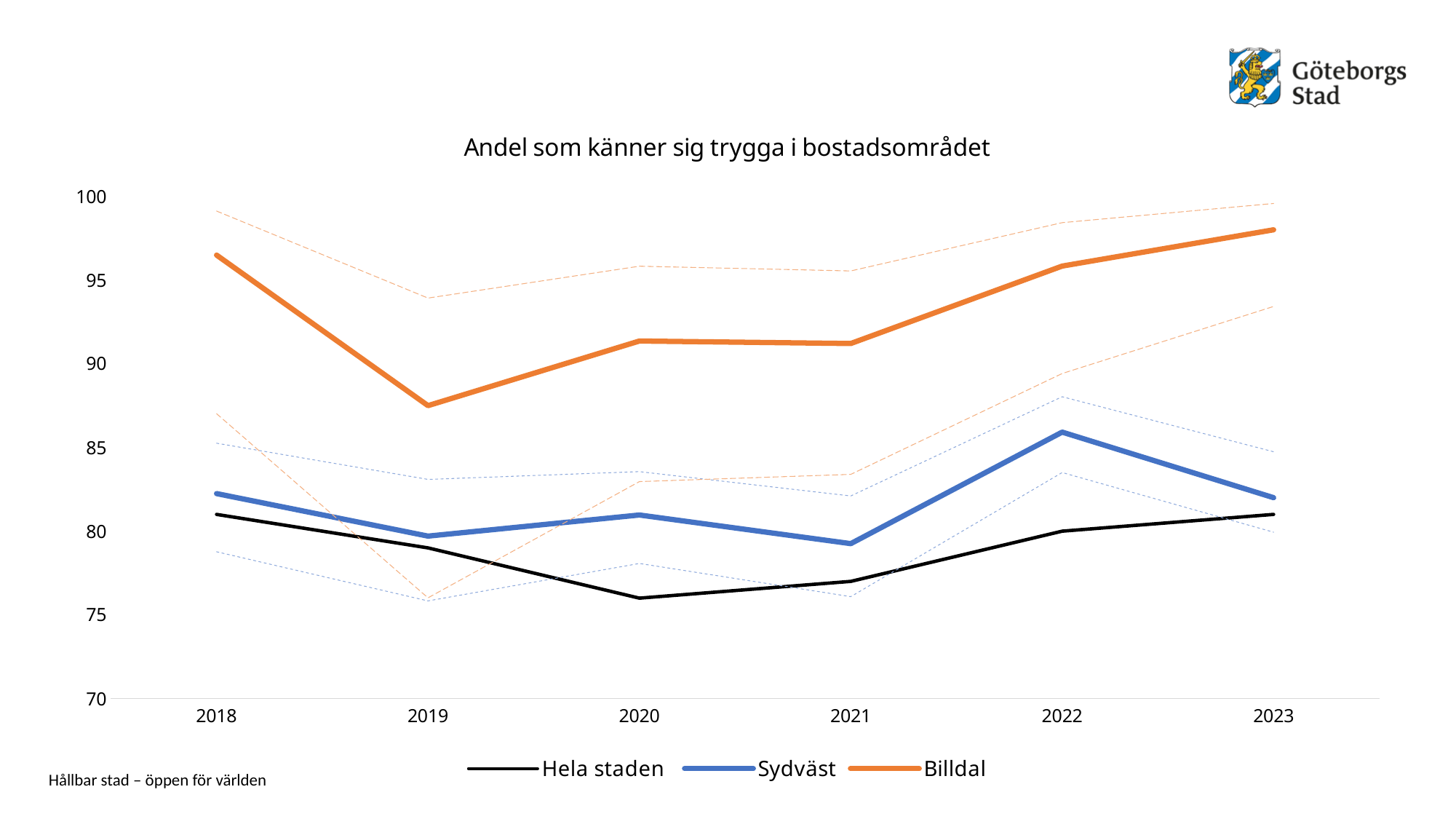
Is the value for Hela staden in 2021 greater or less than 80? less Which is larger in 2022, Sydväst or Hela staden? Sydväst Is the value for Billdal in 2018 greater or less than 95? greater How many series does the legend list? 3 Does the Billdal line rise or fall from 2019 to 2023? rise In which year is the Billdal line at its lowest? 2019 Which series has the highest value in 2023? Billdal How many years are shown on the x axis? 6 What is the title of the chart? Andel som känner sig trygga i bostadsområdet Is the value for Billdal in 2019 greater or less than 90? less What kind of chart is shown on the slide? line chart In which year is the Sydväst line at its highest? 2022